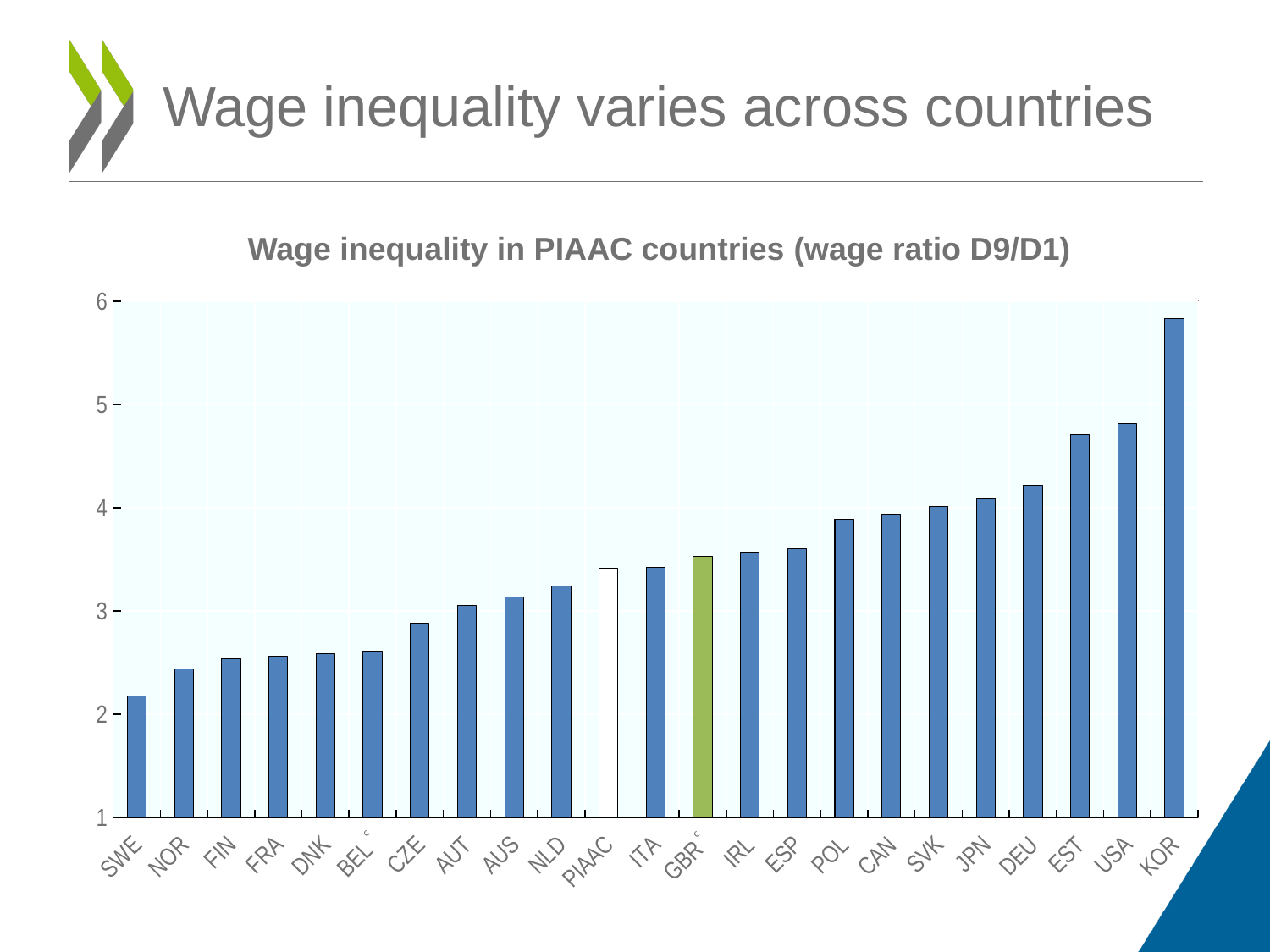
Is the value for USA greater or less than 4? greater Do the bar values rise or fall from left to right along the x axis? rise Which has a larger wage ratio, EST or NOR? EST Is the value for SWE greater or less than 3? less What kind of chart is shown on the slide? bar chart Which country's bar is coloured green in the chart? GBR Is the value for KOR greater or less than 5? greater Which country has the highest wage ratio D9/D1 in the chart? KOR How many bars are plotted in the chart? 23 Which country has the lowest wage ratio D9/D1 in the chart? SWE What is the title of the chart? Wage inequality in PIAAC countries (wage ratio D9/D1)